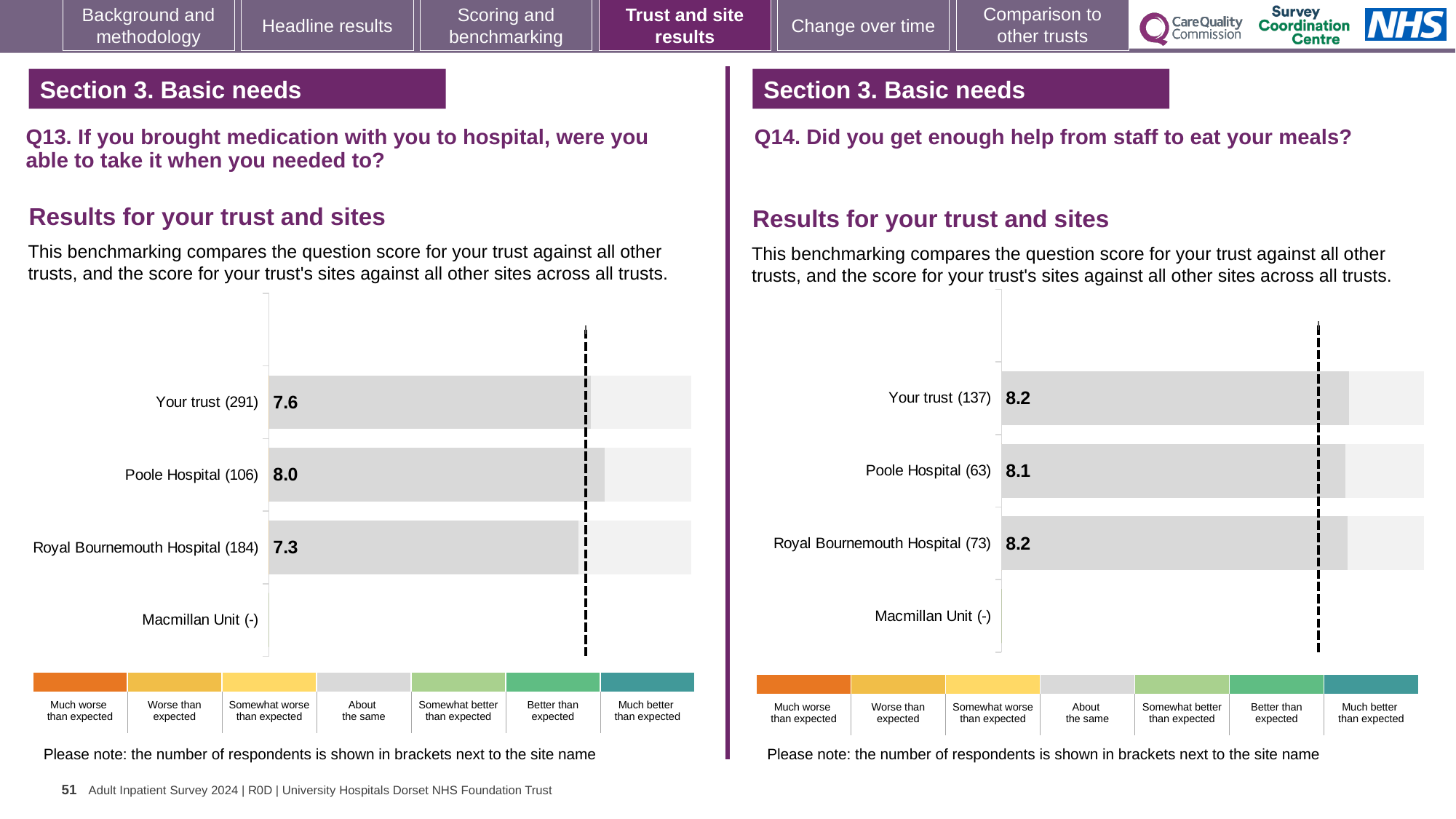
On the Q14 chart (right), how many respondents are shown in brackets for Royal Bournemouth Hospital? 73 On the Q13 chart (left), what is the score for Poole Hospital? 8.0 On the Q13 chart (left), which site has the highest score? Poole Hospital On the Q13 chart (left), what is the difference between the scores for Poole Hospital and Royal Bournemouth Hospital? 0.7 On the Q13 chart (left), what is the score for Your trust? 7.6 On the Q14 chart (right), which site has the lowest score? Poole Hospital What kind of chart is the Q14 chart (right)? Bar chart How many categories (rows) are listed on the Q13 chart (left)? 4 On the Q13 chart (left), which site has the lowest score? Royal Bournemouth Hospital On the Q13 chart (left), what is the score for Royal Bournemouth Hospital? 7.3 On the Q14 chart (right), what is the score for Poole Hospital? 8.1 On the Q14 chart (right), what is the score for Your trust? 8.2